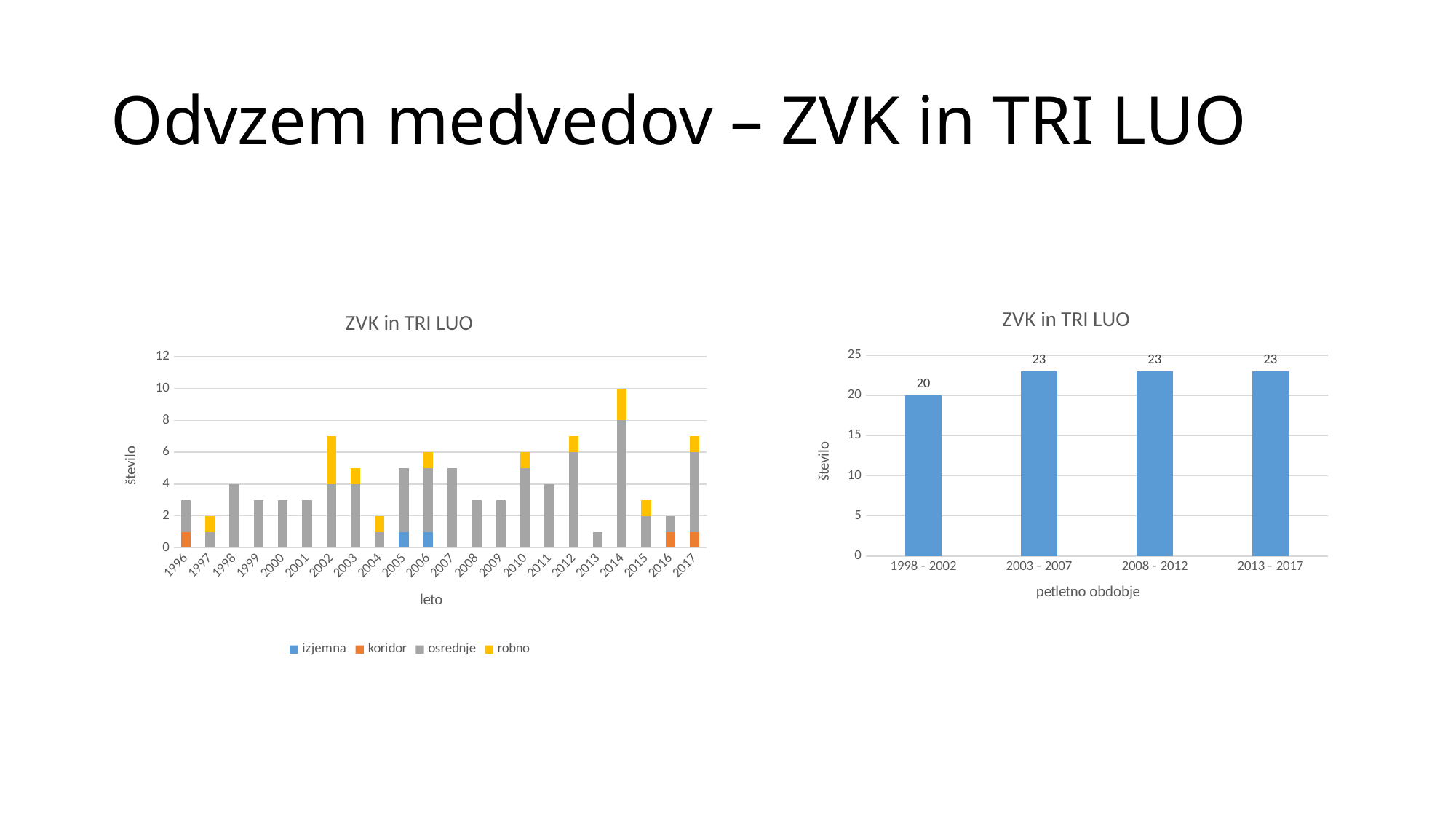
What is the label of the x axis on the right chart? petletno obdobje On the right chart, what is the value for the period 1998 - 2002? 20 On the left chart, is the total value for 2014 greater or less than 8? greater What kind of chart is the right chart? bar chart How many series does the legend of the left chart list? 4 On the left chart, which year has the highest total bar? 2014 On the left chart, is the total value for 2013 greater or less than 2? less How many years are shown on the x axis of the left chart? 22 On the right chart, what is the value for the period 2013 - 2017? 23 How many five-year periods are shown on the right chart? 4 On the right chart, what is the difference between the values for 2003 - 2007 and 1998 - 2002? 3 On the right chart, which five-year period has the lowest value? 1998 - 2002